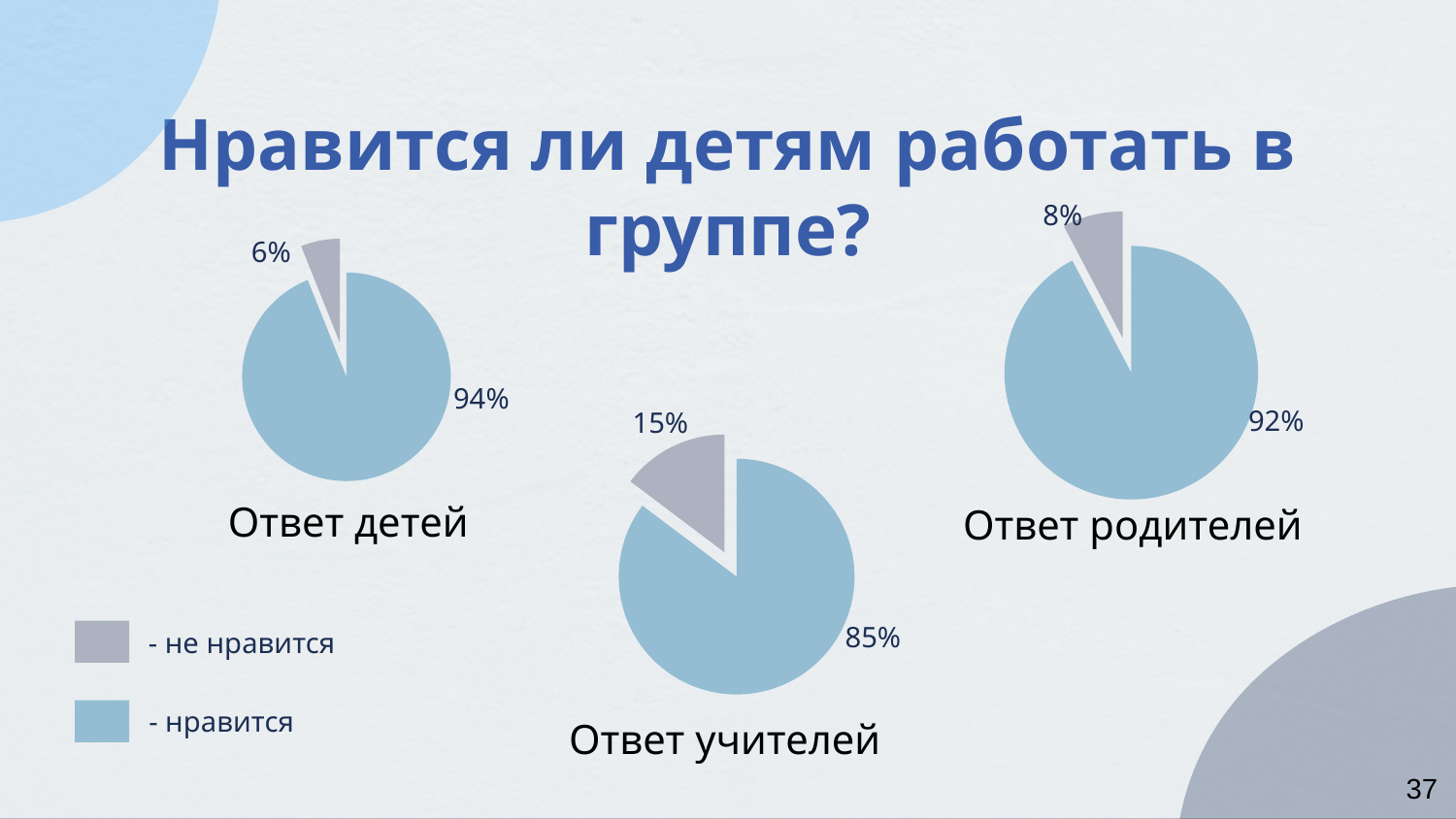
In the pie chart titled "Ответ родителей", what is the value for "не нравится"? 8% Which colour represents "не нравится" in the legend? Grey In the pie chart titled "Ответ детей", what is the value for "не нравится"? 6% How many categories does the legend list? 2 How many pie charts are shown on the slide? 3 What kind of chart is used for "Ответ детей"? Pie chart In the pie chart titled "Ответ детей", what share of the pie is "нравится"? 94% In the pie chart titled "Ответ родителей", what is the value for "нравится"? 92% In the pie chart titled "Ответ учителей", what is the difference between "нравится" and "не нравится"? 70% Which chart has the largest "не нравится" slice: "Ответ детей", "Ответ учителей" or "Ответ родителей"? Ответ учителей In the pie chart titled "Ответ учителей", what share of the pie is "нравится"? 85% In the pie chart titled "Ответ учителей", what is the value for "не нравится"? 15%